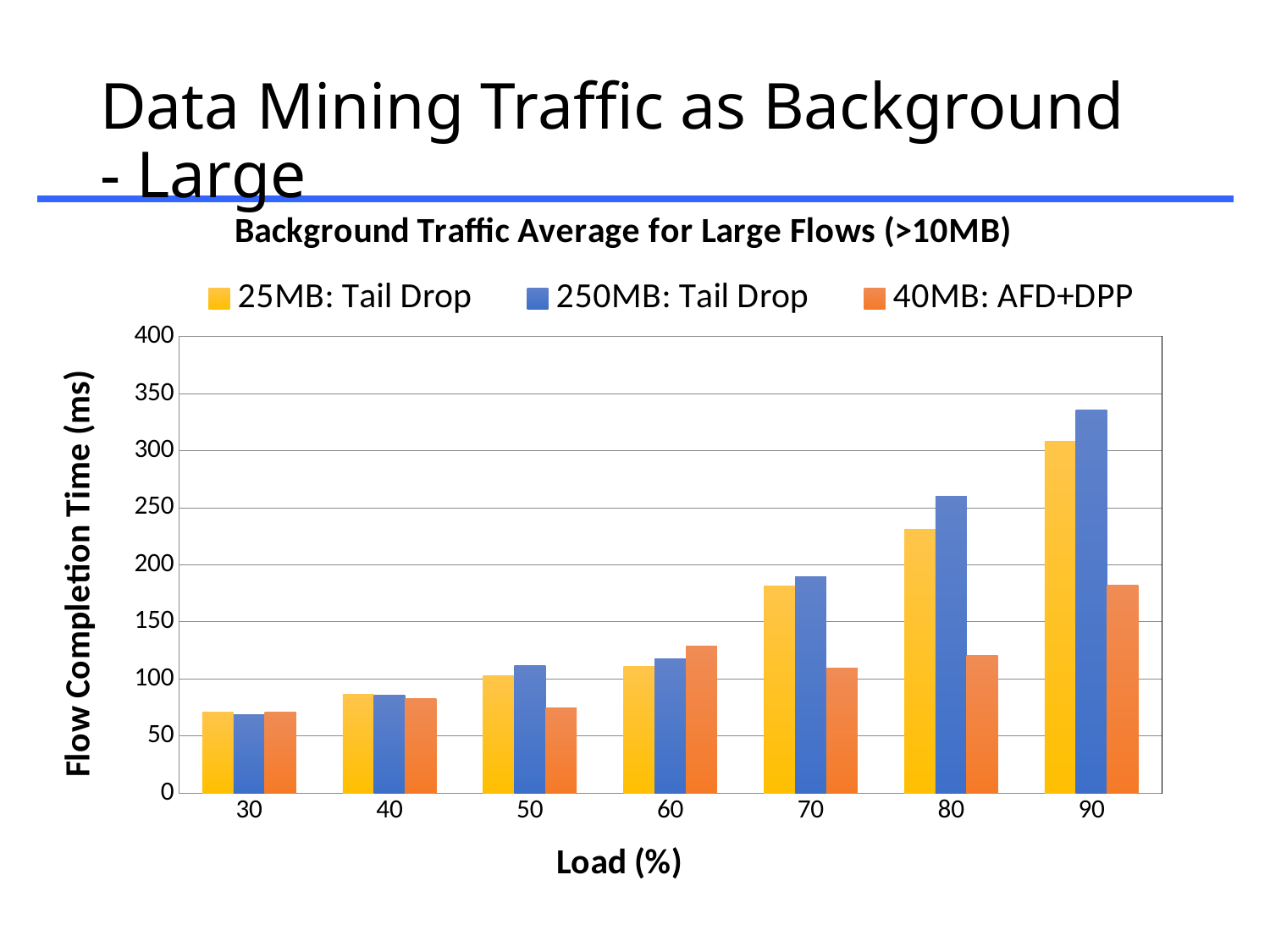
Which series has the lowest value at 90% load? 40MB: AFD+DPP Is the value for 40MB: AFD+DPP at 90% load greater or less than 200? less What is the label of the y axis? Flow Completion Time (ms) Is the value for 25MB: Tail Drop at 30% load greater or less than 100? less How many series does the legend list? 3 Do the 25MB: Tail Drop values rise or fall as load increases from 30 to 90? rise How many load levels are shown on the x axis? 7 What kind of chart is shown on the slide? bar chart At 60% load, which is larger: 40MB: AFD+DPP or 25MB: Tail Drop? 40MB: AFD+DPP At 80% load, which is larger: 250MB: Tail Drop or 40MB: AFD+DPP? 250MB: Tail Drop At which load is the 250MB: Tail Drop flow completion time highest? 90 Is the value for 250MB: Tail Drop at 90% load greater or less than 300? greater